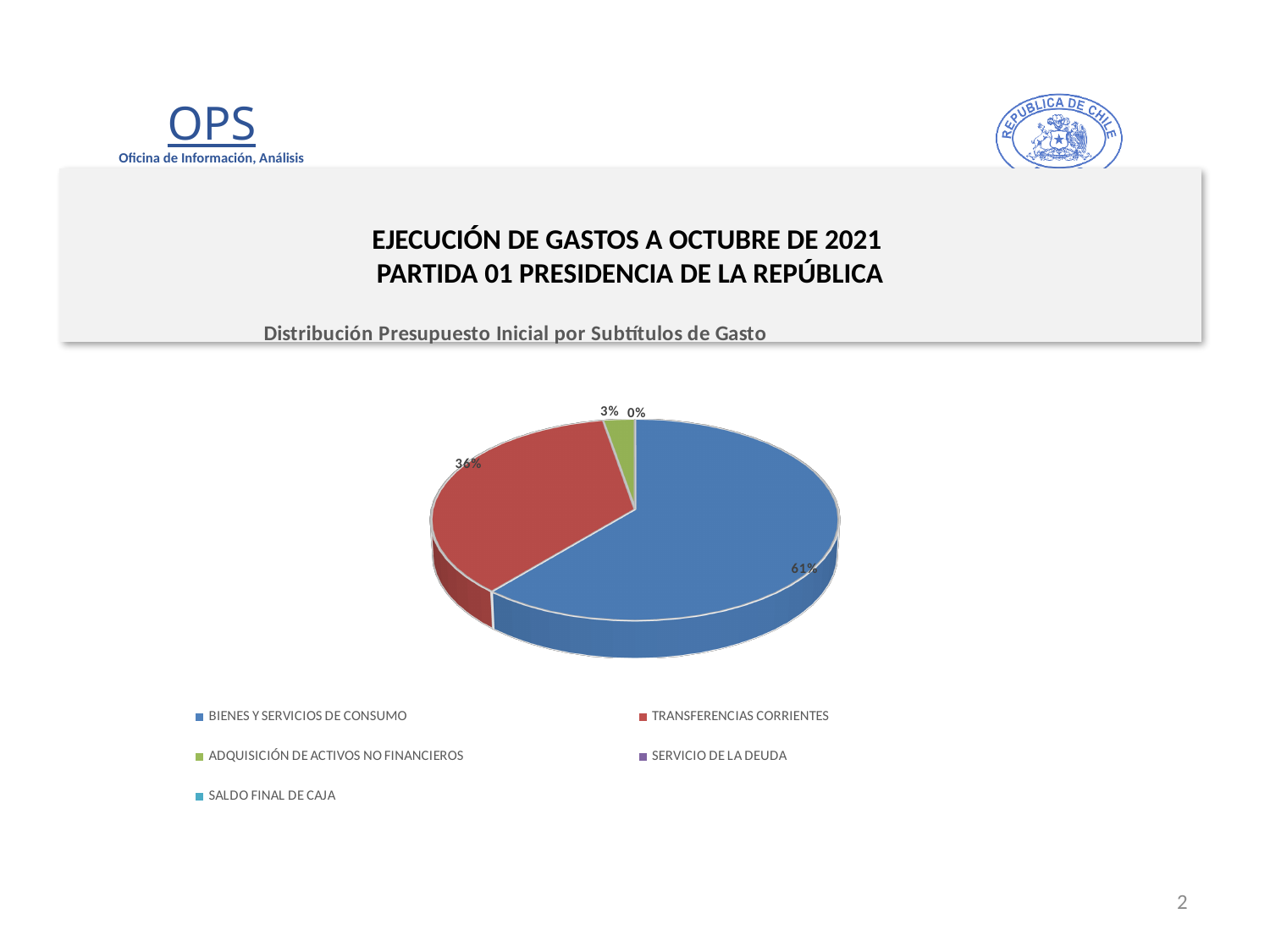
Which category has the largest slice of the pie? BIENES Y SERVICIOS DE CONSUMO How many categories does the legend list? 5 Is the share for BIENES Y SERVICIOS DE CONSUMO greater or less than 50%? greater What kind of chart is shown on the slide? Pie chart Which colour represents TRANSFERENCIAS CORRIENTES in the pie chart? Red What share of the pie does ADQUISICIÓN DE ACTIVOS NO FINANCIEROS represent? 3% What share of the pie does BIENES Y SERVICIOS DE CONSUMO represent? 61% By how many percentage points does BIENES Y SERVICIOS DE CONSUMO exceed TRANSFERENCIAS CORRIENTES? 25 percentage points Which is larger, the slice for TRANSFERENCIAS CORRIENTES or the slice for ADQUISICIÓN DE ACTIVOS NO FINANCIEROS? TRANSFERENCIAS CORRIENTES What is the title of the chart? Distribución Presupuesto Inicial por Subtítulos de Gasto What share of the pie does TRANSFERENCIAS CORRIENTES represent? 36%